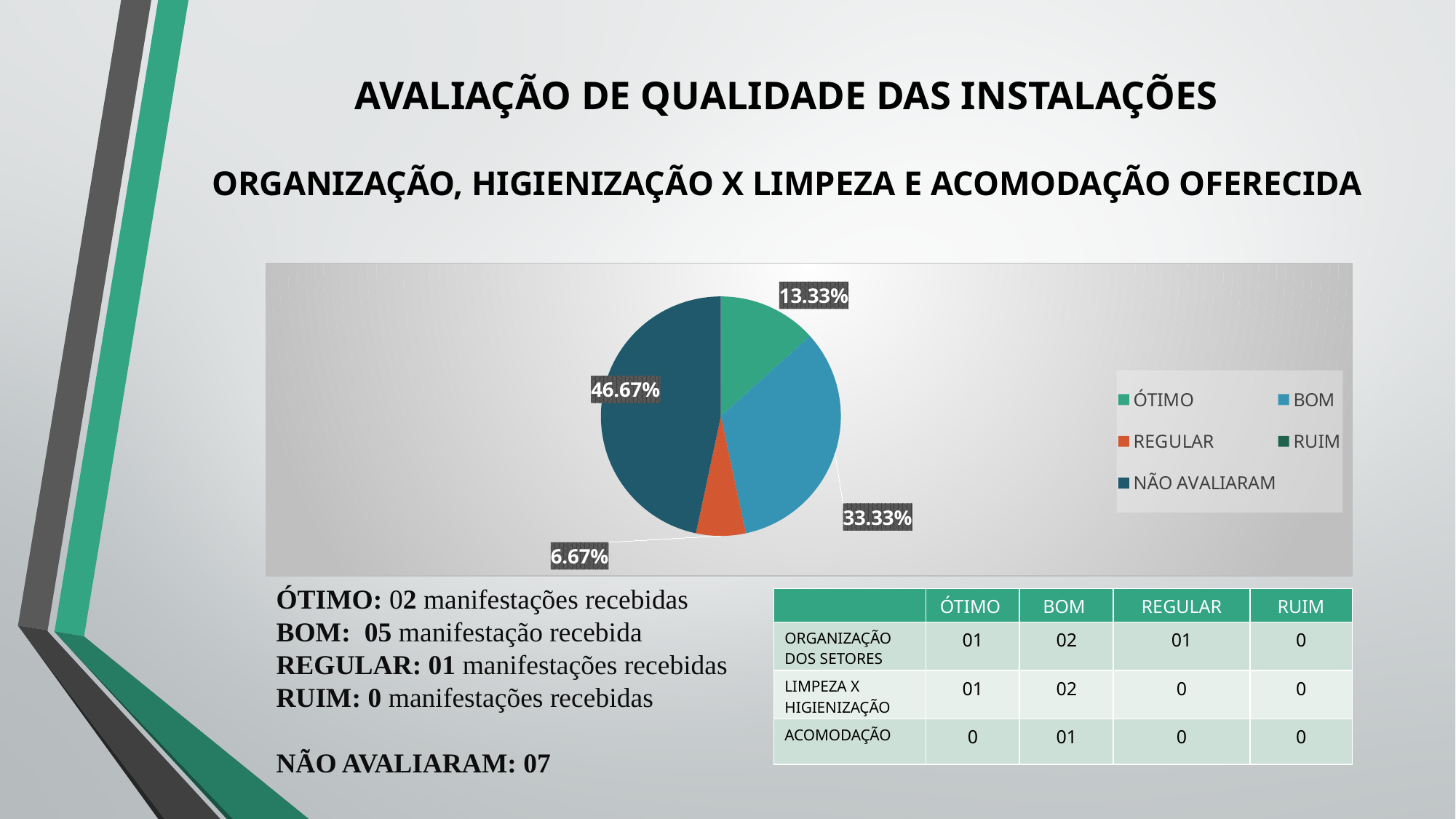
What share of the pie does the BOM slice represent? 33.33% What is the difference in percentage points between the NÃO AVALIARAM slice and the BOM slice? 13.34% Which legend entry is shown in orange? REGULAR Which slice is larger, BOM or ÓTIMO? BOM What kind of chart is shown on the slide? pie chart Which category with a visible slice has the smallest share of the pie? REGULAR What share of the pie does the REGULAR slice represent? 6.67% Is the share of the NÃO AVALIARAM slice greater or less than 50%? less What share of the pie does the NÃO AVALIARAM slice represent? 46.67% Which category has the largest slice of the pie? NÃO AVALIARAM How many entries does the legend of the pie chart list? 5